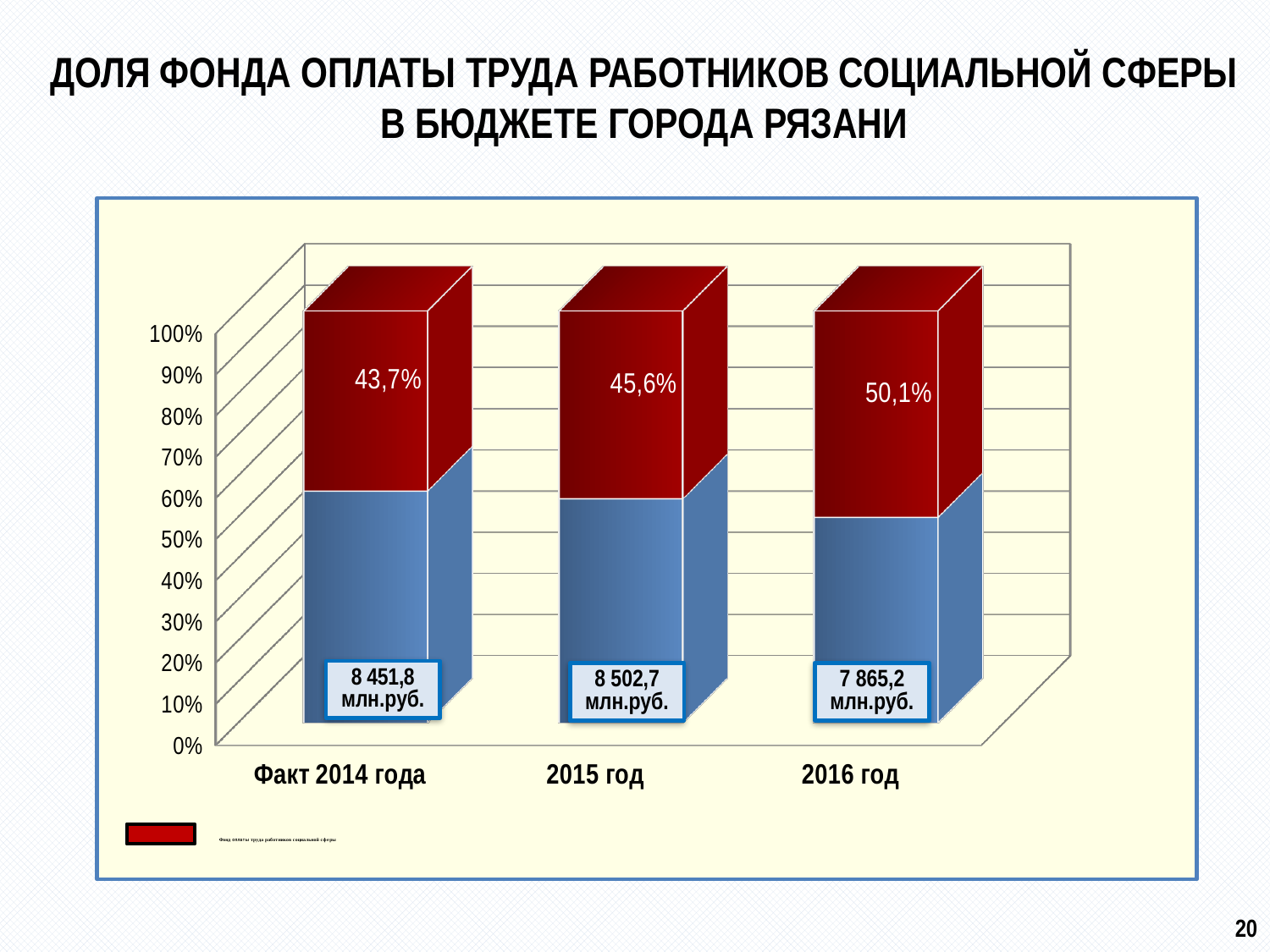
Which year has the highest red-segment share? 2016 год How many categories (years) are shown on the x axis? 3 Does the red-segment share rise or fall from Факт 2014 года to 2016 год? rise What amount in млн.руб. is labelled on the bar for 2016 год? 7 865,2 млн.руб. Which year has the lowest red-segment share? Факт 2014 года What is the difference between the млн.руб. amounts labelled for 2015 год and 2016 год? 637,5 млн.руб. What is the share shown for the red segment in 2016 год? 50,1% What amount in млн.руб. is labelled on the bar for 2015 год? 8 502,7 млн.руб. By how many percentage points does the red-segment share in 2016 год exceed that in Факт 2014 года? 6,4 What is the share shown for the red segment in 2015 год? 45,6% What is the share shown for the red segment in Факт 2014 года? 43,7% Which is larger, the red-segment share for 2015 год or for Факт 2014 года? 2015 год